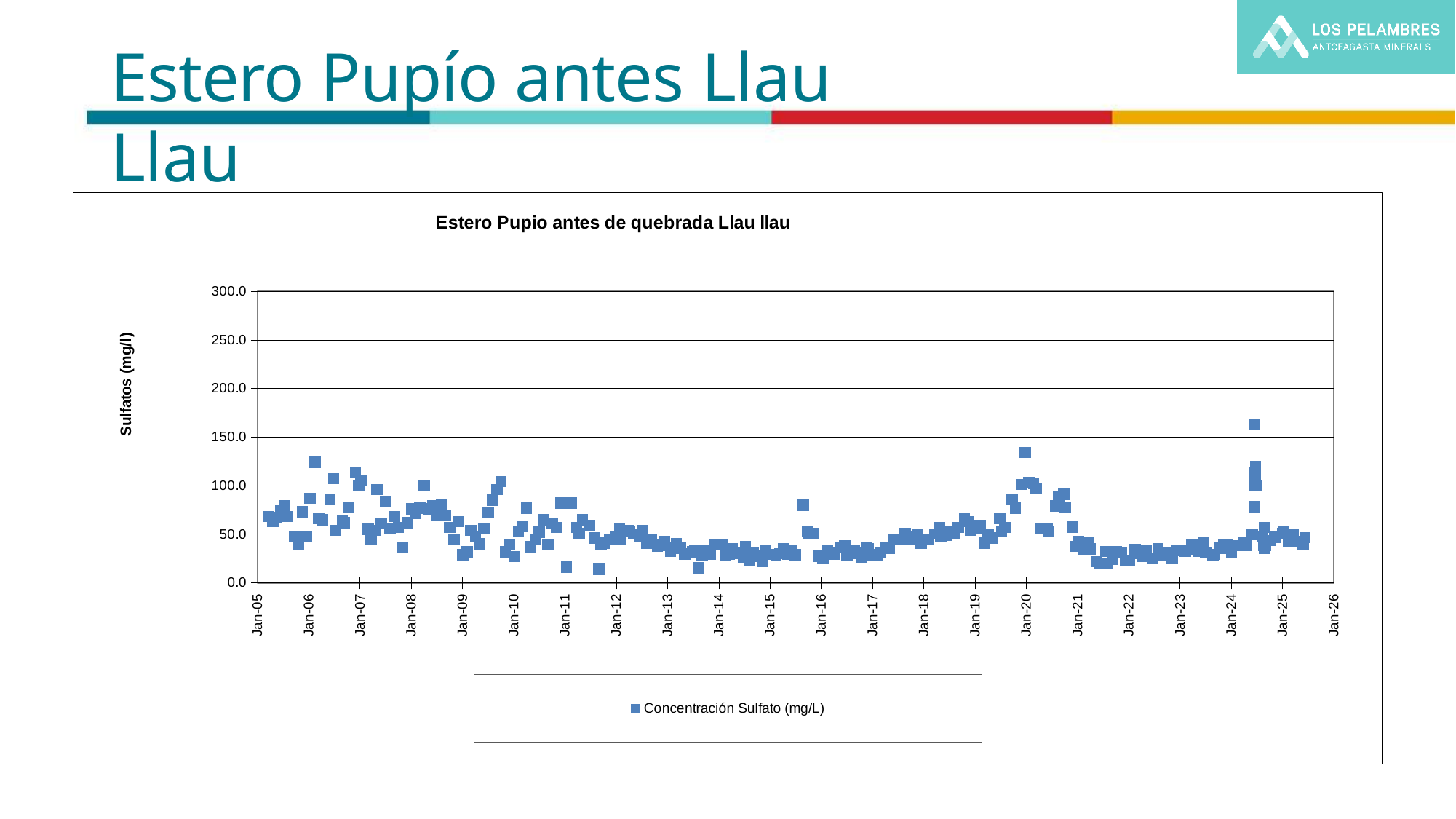
Between Jan-17 and Jan-20, do the sulfate values generally rise or fall? rise Is the highest plotted sulfate value greater or less than 200.0? less Are the values plotted around Jan-15 greater or less than 50.0? less What kind of chart is shown on the slide? scatter chart In which year does the highest sulfate concentration on the chart occur? 2024 Is the peak value near Jan-20 greater or less than 150.0? less What is the name of the series shown in the legend? Concentración Sulfato (mg/L) How many year labels are shown on the x axis, from Jan-05 to Jan-26? 22 Between Jan-12 and Jan-15, do the sulfate values generally rise or fall? fall How many series does the chart legend list? 1 What is the title of the chart? Estero Pupio antes de quebrada Llau llau